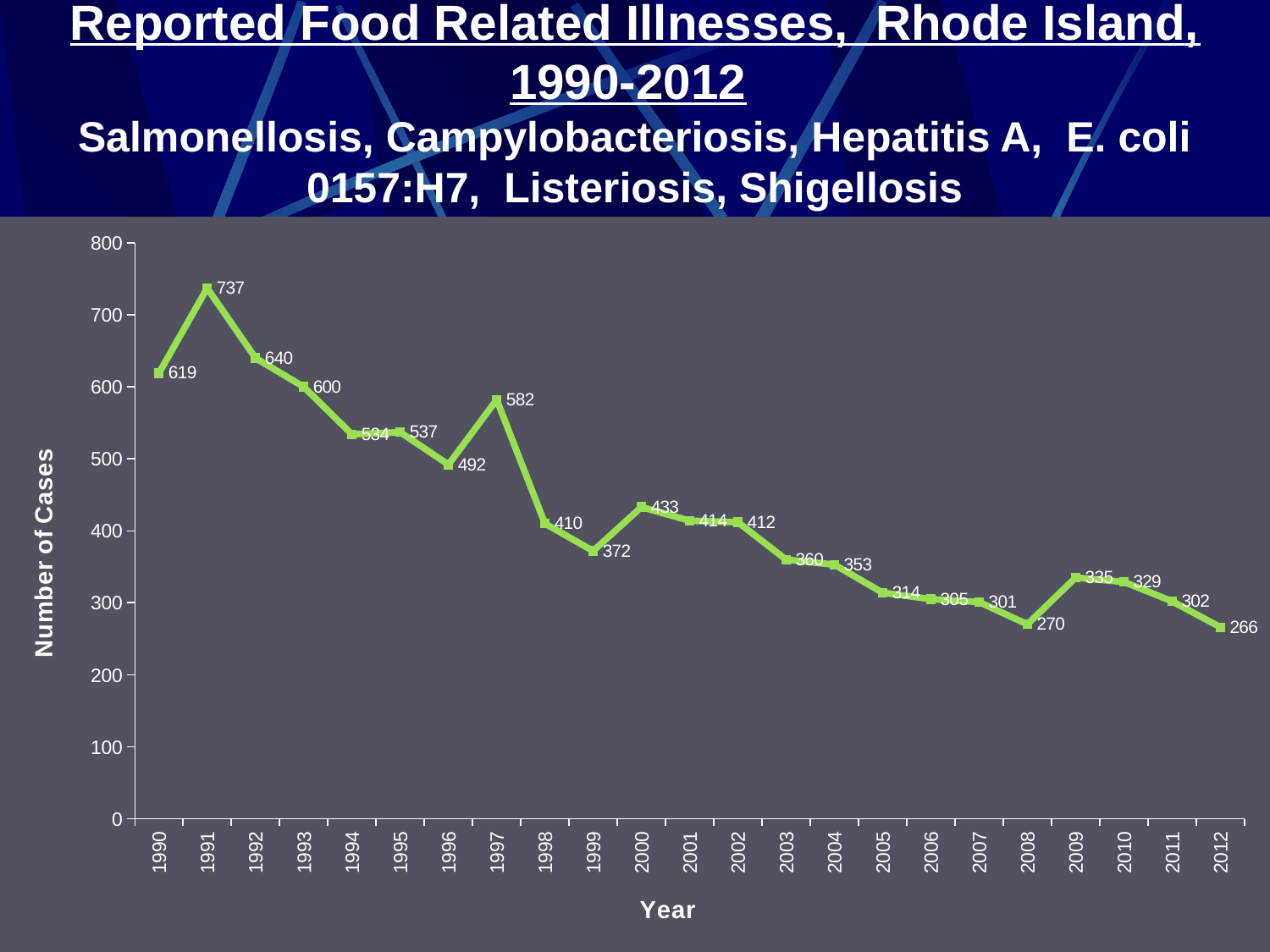
Which year had the highest number of cases? 1991 What is the difference in the number of cases between 1991 and 2012? 471 Do the number of cases generally rise or fall from 1991 to 2012? fall What type of chart is shown on the slide? line chart Which year had more cases, 1996 or 1997? 1997 Is the value for 2008 greater or less than 300? less How many cases were reported in 2012? 266 How many years are plotted on the x axis? 23 What is the label of the y axis? Number of Cases Which year had the lowest number of cases? 2012 How many cases were reported in 1991? 737 How many cases were reported in 1997? 582